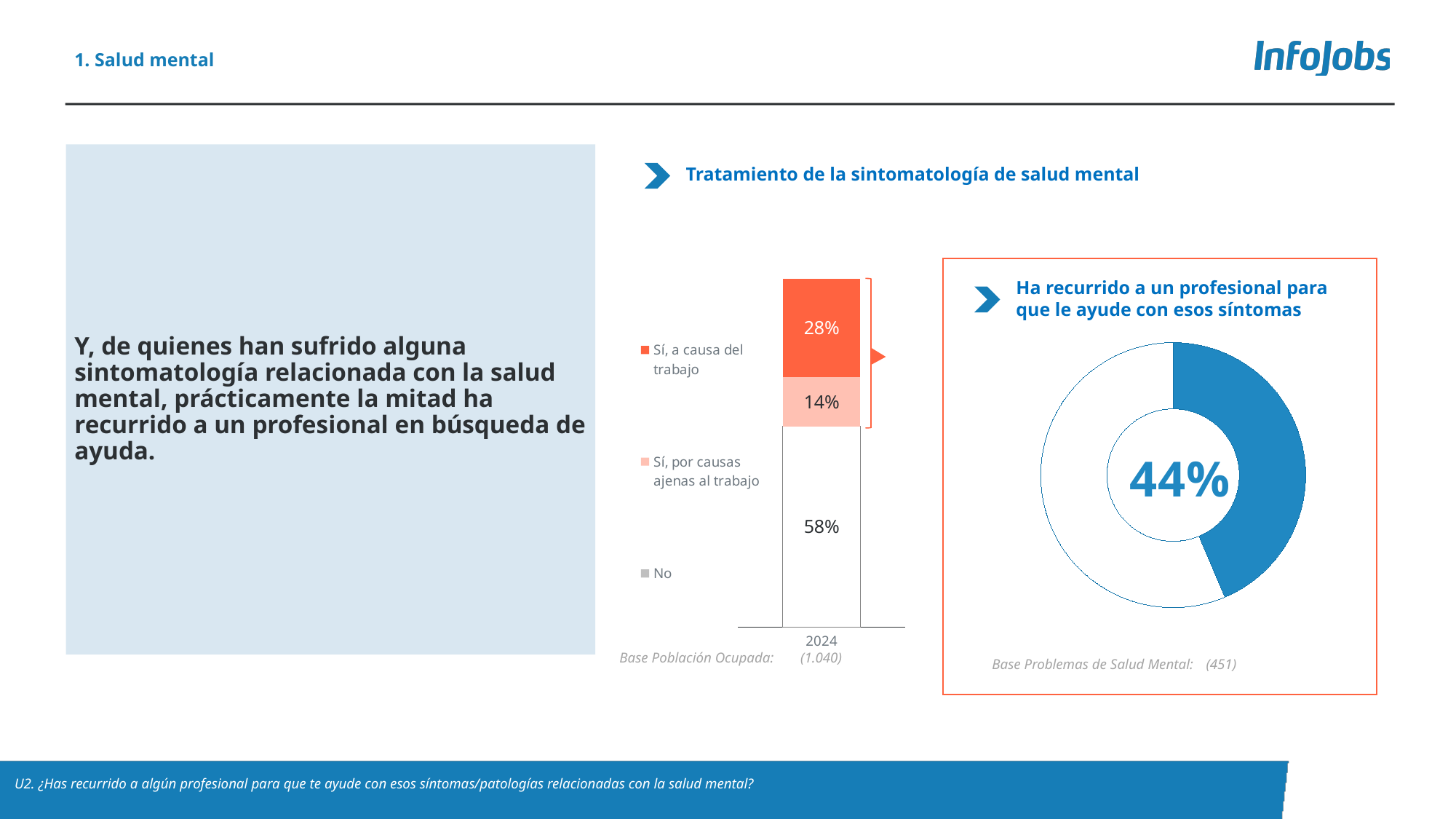
In the stacked bar chart 'Tratamiento de la sintomatología de salud mental', which segment has the largest value? No In the stacked bar chart 'Tratamiento de la sintomatología de salud mental', what is the value for 'Sí, a causa del trabajo'? 28% In the stacked bar chart 'Tratamiento de la sintomatología de salud mental', which segment has the smallest value? Sí, por causas ajenas al trabajo How many series does the legend of the stacked bar chart 'Tratamiento de la sintomatología de salud mental' list? 3 In the donut chart 'Ha recurrido a un profesional para que le ayude con esos síntomas', what share is shown in the centre? 44% What year is shown on the x axis of the stacked bar chart 'Tratamiento de la sintomatología de salud mental'? 2024 In the stacked bar chart 'Tratamiento de la sintomatología de salud mental', what is the difference between 'Sí, a causa del trabajo' and 'Sí, por causas ajenas al trabajo'? 14% In the stacked bar chart 'Tratamiento de la sintomatología de salud mental', what is the value for 'No'? 58% In the stacked bar chart 'Tratamiento de la sintomatología de salud mental', which is larger: 'No' or 'Sí, a causa del trabajo'? No What kind of chart is the one on the right titled 'Ha recurrido a un profesional para que le ayude con esos síntomas'? Donut chart In the stacked bar chart 'Tratamiento de la sintomatología de salud mental', what is the value for 'Sí, por causas ajenas al trabajo'? 14% In the stacked bar chart 'Tratamiento de la sintomatología de salud mental', what is the combined total of the two 'Sí' segments? 42%